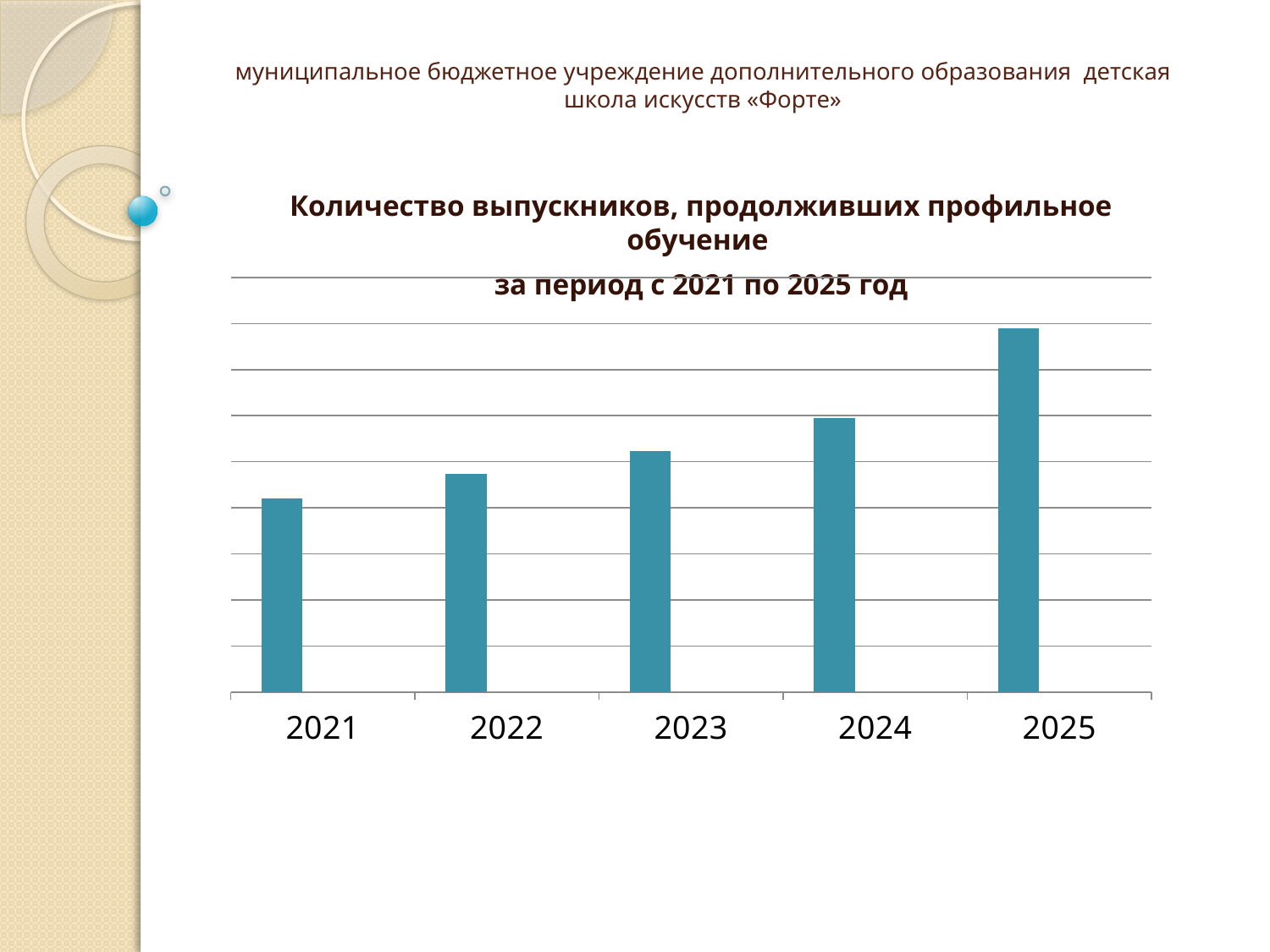
Which year has the lowest number of graduates who continued specialised education? 2021 What is the first year shown on the x axis? 2021 Which year has the larger value, 2022 or 2024? 2024 Which year has the highest number of graduates who continued specialised education? 2025 How many years are shown on the x axis of the chart? 5 Which year has the larger value, 2025 or 2023? 2025 Do the values rise or fall from 2021 to 2025? rise What period does the chart title say the data covers? с 2021 по 2025 год Which year has the smaller value, 2022 or 2023? 2022 What kind of chart is shown on the slide? bar chart